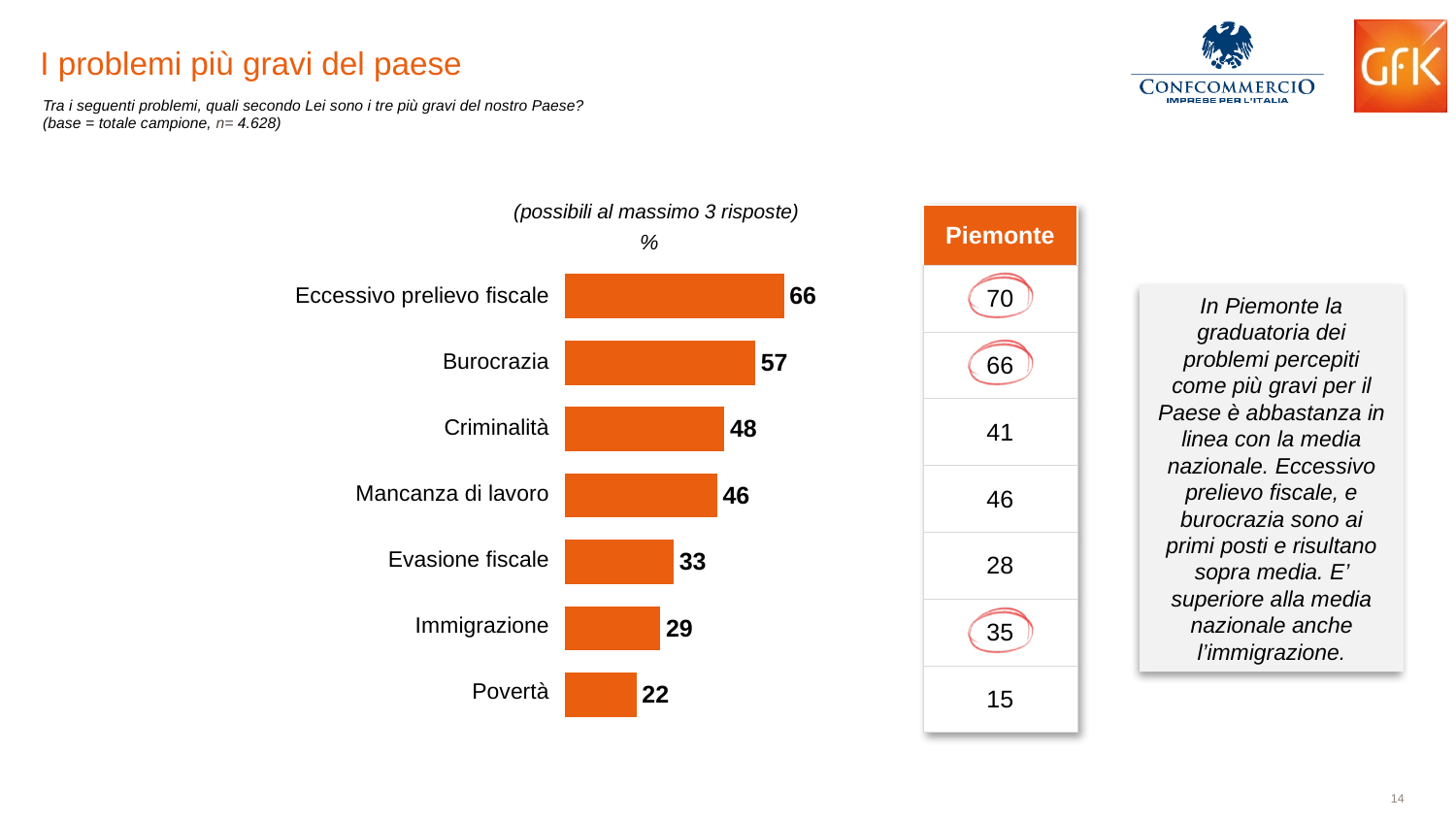
What is the value for Mancanza di lavoro in the bar chart? 46 Which has a larger value in the bar chart, Criminalità or Evasione fiscale? Criminalità Which category has the highest value in the bar chart? Eccessivo prelievo fiscale What is the value for Immigrazione in the bar chart? 29 What is the value for Eccessivo prelievo fiscale in the bar chart? 66 What type of chart is shown on the slide? Bar chart What is the value for Burocrazia in the bar chart? 57 What is the difference between the values for Eccessivo prelievo fiscale and Burocrazia in the bar chart? 9 How many categories are shown in the bar chart? 7 What is the title of the slide containing the bar chart? I problemi più gravi del paese Which category has the lowest value in the bar chart? Povertà What is the difference between the values for Evasione fiscale and Povertà in the bar chart? 11